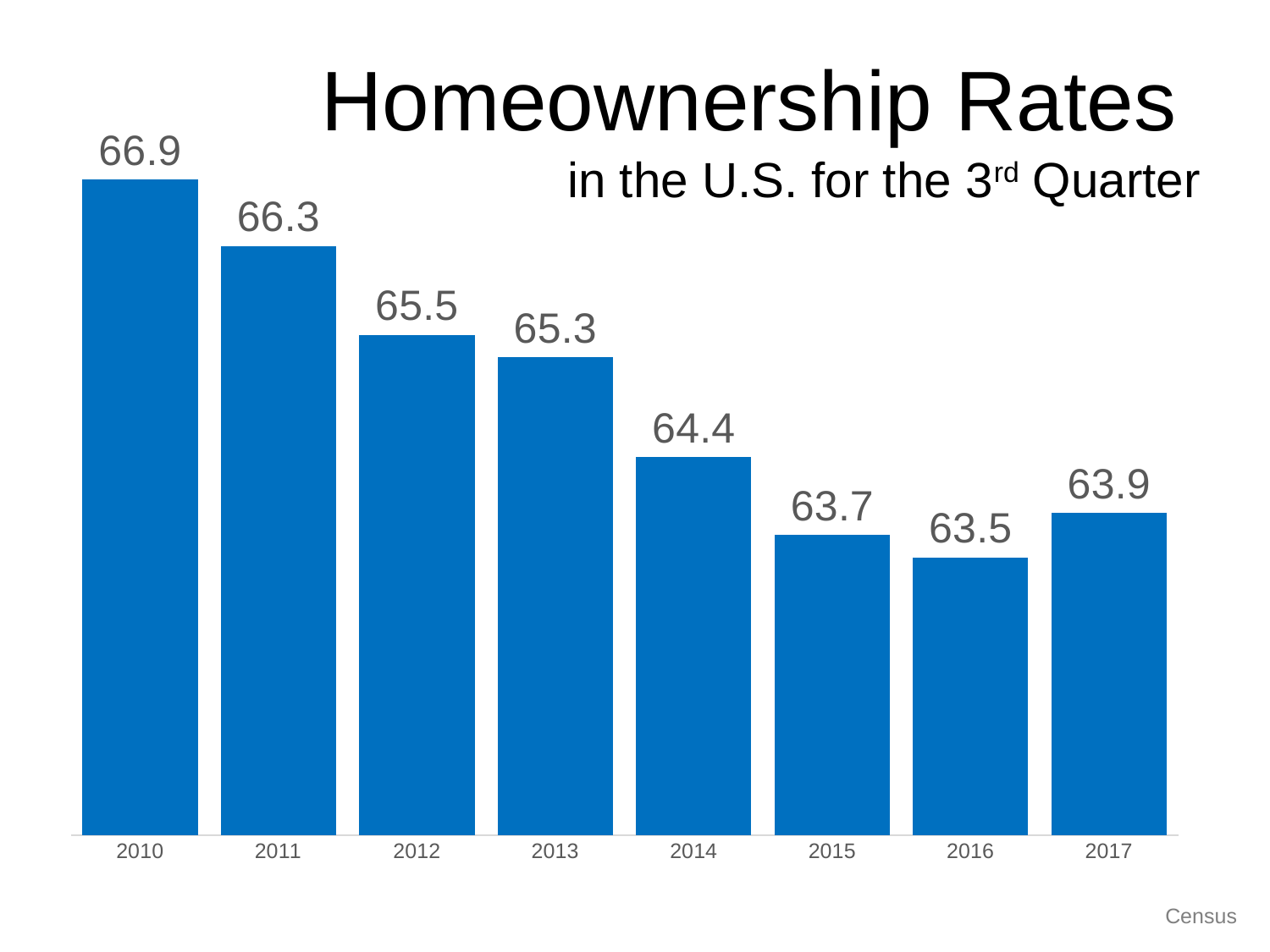
What kind of chart is shown on the slide? Bar chart What is the homeownership rate shown for 2010? 66.9 What is the difference between the homeownership rates for 2010 and 2017? 3.0 Which year has a higher homeownership rate, 2012 or 2015? 2012 What source is cited at the bottom of the slide? Census How many years are shown on the chart? 8 Do the homeownership rates generally rise or fall from 2010 to 2016? Fall What is the homeownership rate shown for 2017? 63.9 What is the difference between the homeownership rates for 2013 and 2014? 0.9 Which year has the highest homeownership rate? 2010 What is the homeownership rate shown for 2014? 64.4 Which year has the lowest homeownership rate? 2016